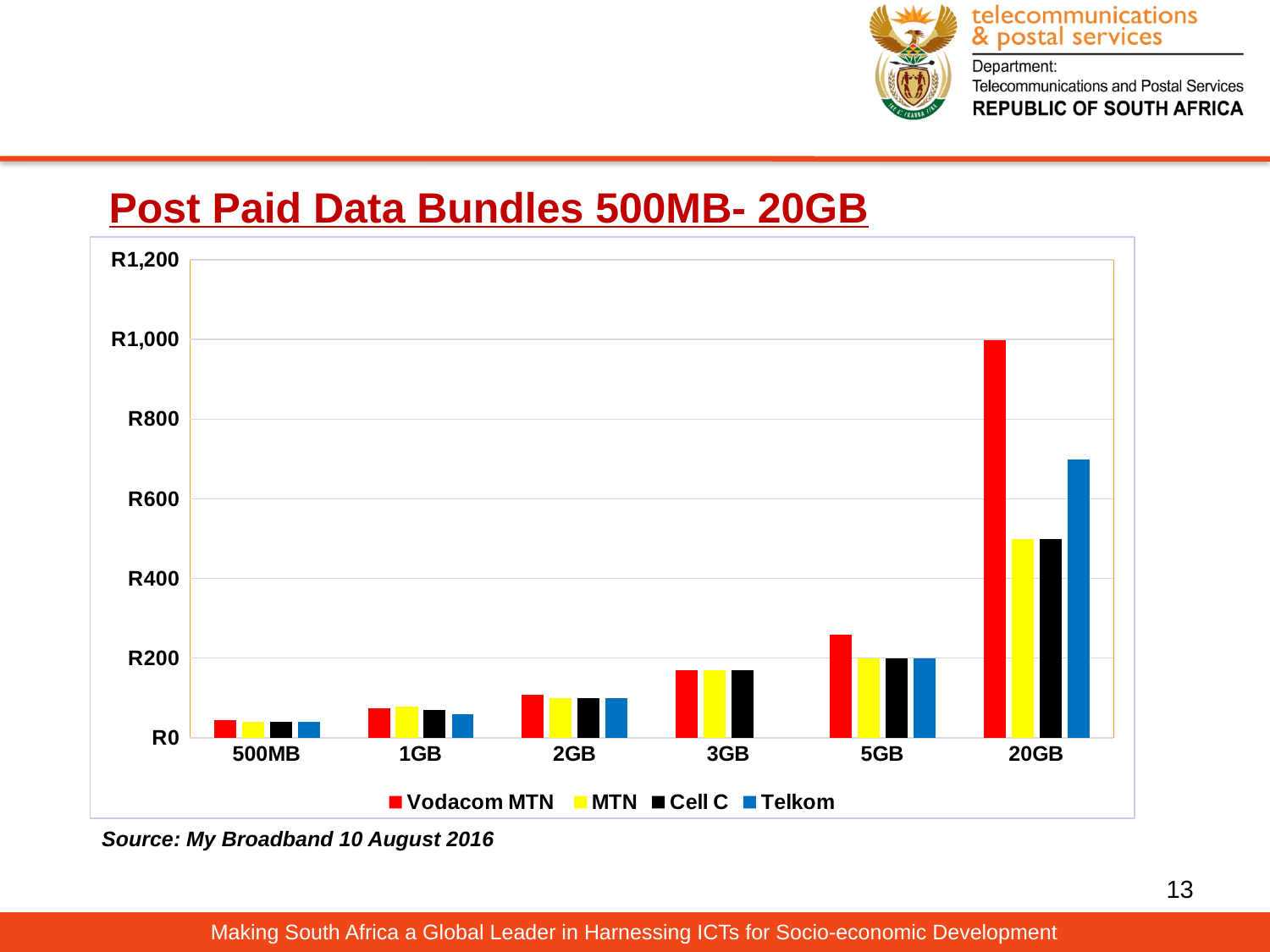
How many series does the legend list? 4 Which is larger at 20GB, the Telkom bar or the MTN bar? Telkom How many data bundle categories are shown on the x axis? 6 What is the title of the chart? Post Paid Data Bundles 500MB- 20GB Which series has the highest bar in the 20GB category? Vodacom MTN Is the value for Telkom at 20GB greater or less than R600? greater Is the value for Vodacom MTN at 20GB greater or less than R800? greater Is the value for MTN at 20GB greater or less than R600? less Do the prices generally rise or fall as the bundle size increases from 500MB to 20GB? Rise What kind of chart is shown on the slide? Bar chart Which data bundle category has the tallest bars overall? 20GB